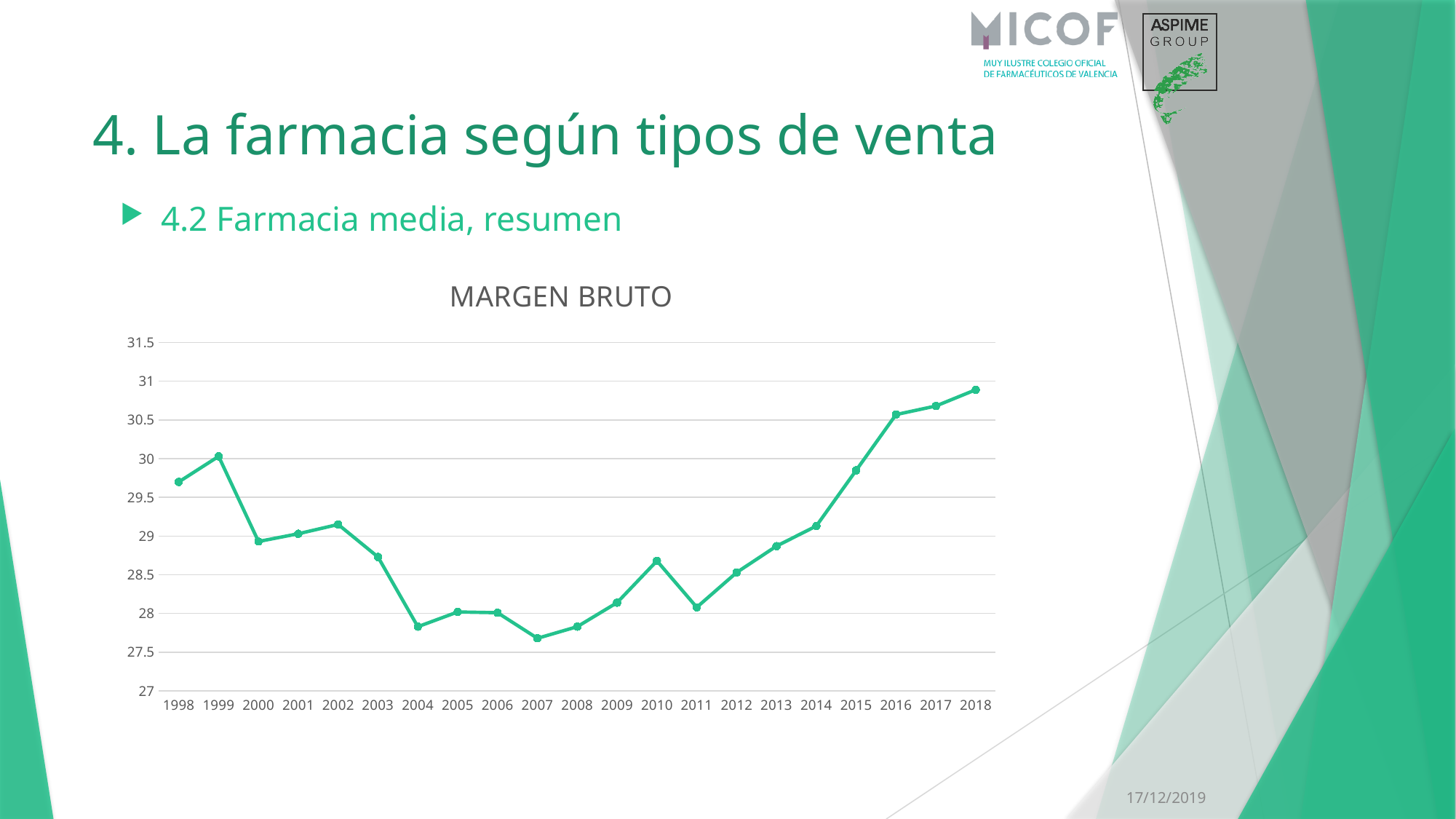
Which year has the lowest value in the chart? 2007 Is the value for 2007 greater or less than 28? less Which year has the larger value, 1999 or 2000? 1999 Which year has the highest value in the chart? 2018 Is the value for 1998 greater or less than 29.5? greater What kind of chart is shown on the slide? line chart What is the title of the chart? MARGEN BRUTO Do the values rise or fall from 2011 to 2018? rise Which year has the larger value, 2010 or 2011? 2010 How many years are plotted on the x axis of the chart? 21 Is the value for 2003 greater or less than 29? less